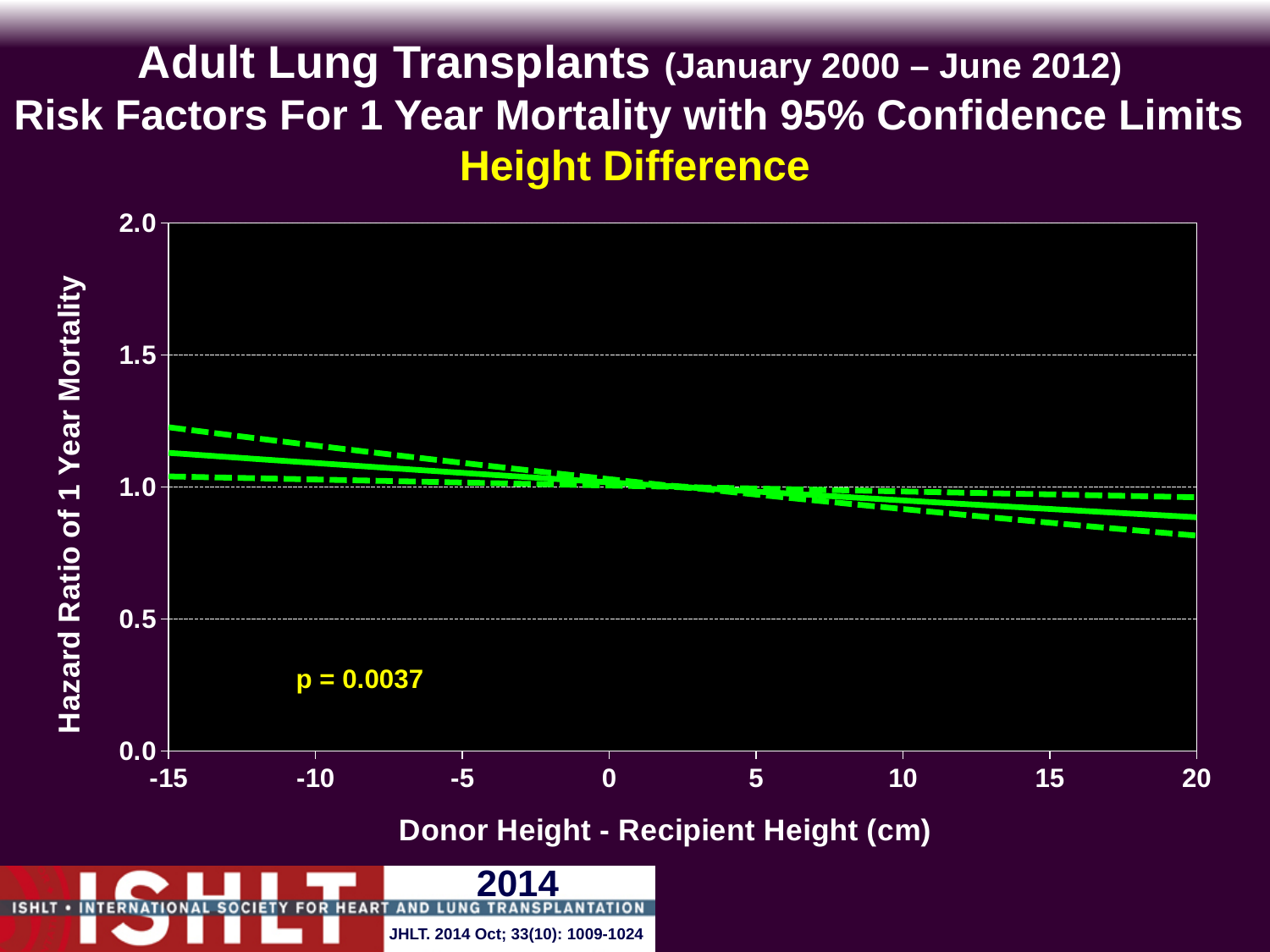
Is the hazard ratio on the solid line larger at a height difference of -15 cm or at 20 cm? -15 cm What p-value is printed on the chart? p = 0.0037 What is the highest value shown on the y axis? 2.0 Is the upper confidence limit at a height difference of -15 cm greater or less than 1.5? less What kind of chart is shown on the slide? line chart Is the hazard ratio on the solid line at a height difference of 20 cm greater or less than 1.0? less How many lines are plotted on the chart (including the confidence limit lines)? 3 Is the lower confidence limit at a height difference of 20 cm greater or less than 1.0? less How many tick labels are shown on the x axis? 8 Does the hazard ratio of 1 year mortality rise or fall as the donor height minus recipient height increases from -15 to 20 cm? fall